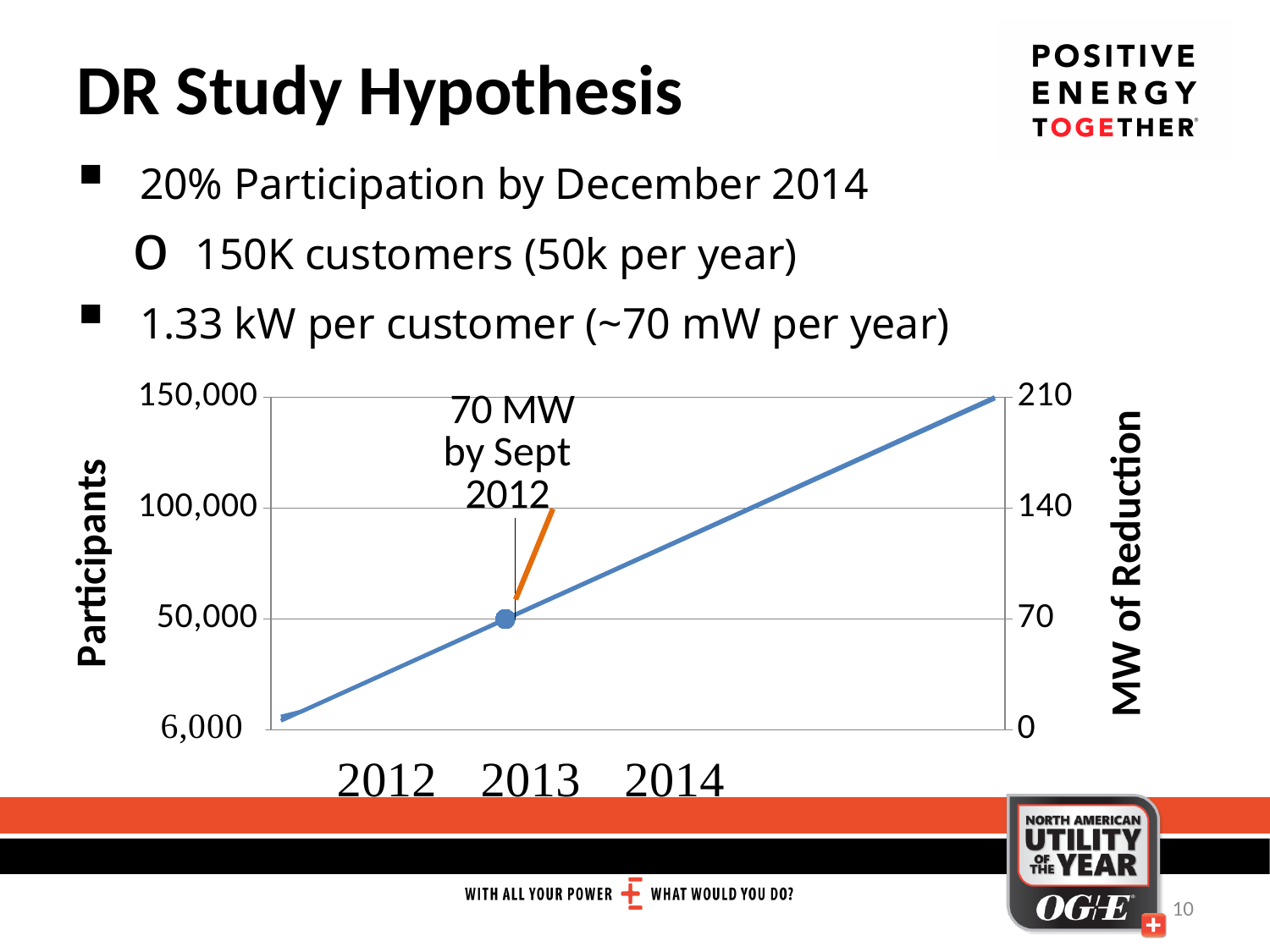
What is the label of the left vertical axis? Participants What kind of chart is shown on the slide? line chart What MW of Reduction value on the right axis corresponds to the highlighted marker point? 70 What is the highest tick value shown on the MW of Reduction axis? 210 What is the label of the right vertical axis? MW of Reduction Is the participant value at the end of 2014 greater or less than 100,000? greater Is the participant value at the start of 2012 greater or less than 50,000? less How many years are labelled along the x axis? 3 Do the plotted participant values rise or fall from 2012 to 2014? rise What is the lowest tick value shown on the Participants axis? 6,000